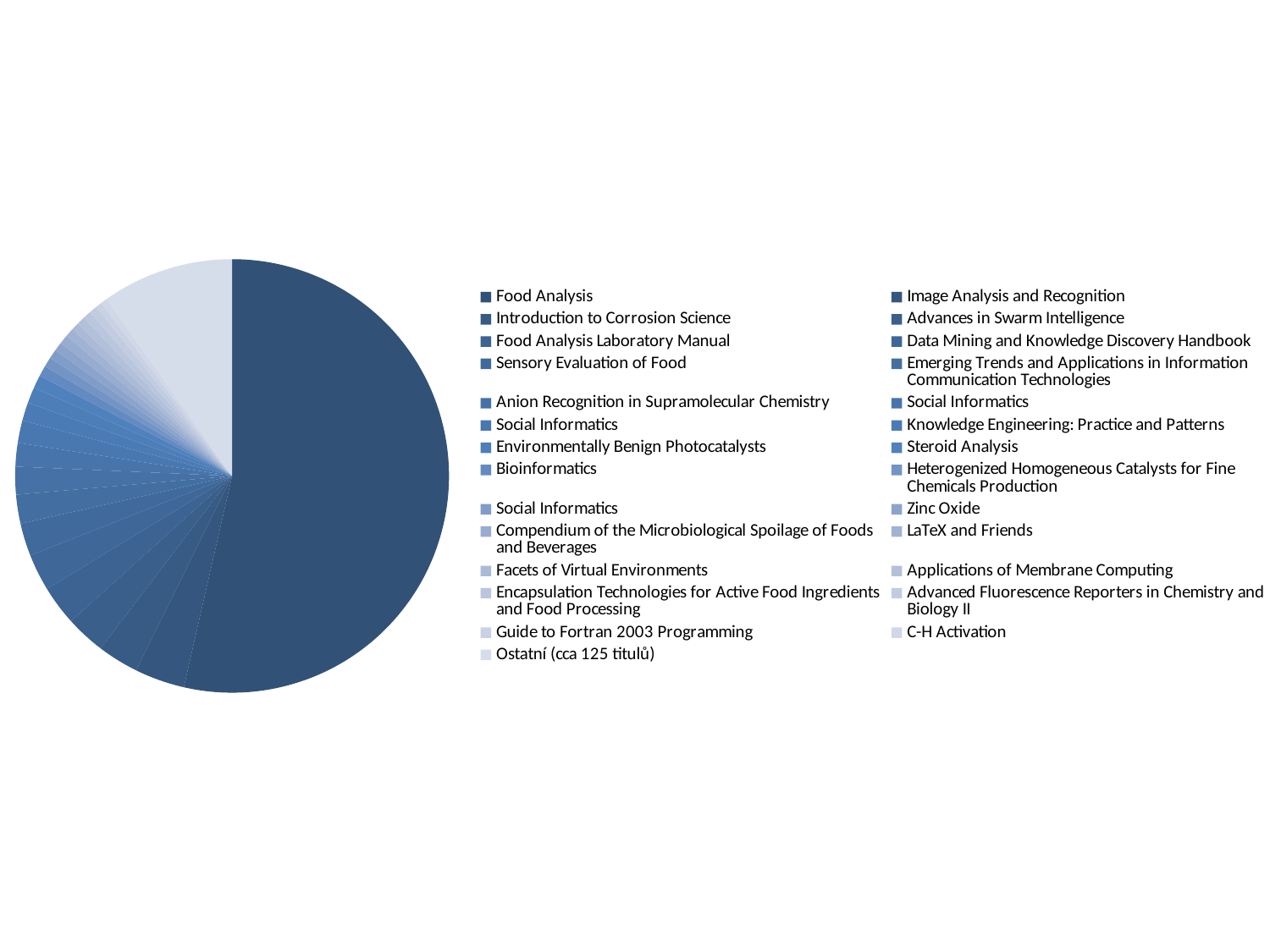
What kind of chart is shown on the slide? pie chart Which slice is larger, Food Analysis or Introduction to Corrosion Science? Food Analysis Which slice is larger, Food Analysis or Ostatní (cca 125 titulů)? Food Analysis Which legend entry groups the remaining roughly 125 titles? Ostatní (cca 125 titulů) Which slice is larger, Ostatní (cca 125 titulů) or Introduction to Corrosion Science? Ostatní (cca 125 titulů) Which category has the largest slice of the pie? Food Analysis How many entries does the legend of the pie chart list? 27 How many times does the title "Social Informatics" appear in the legend? 3